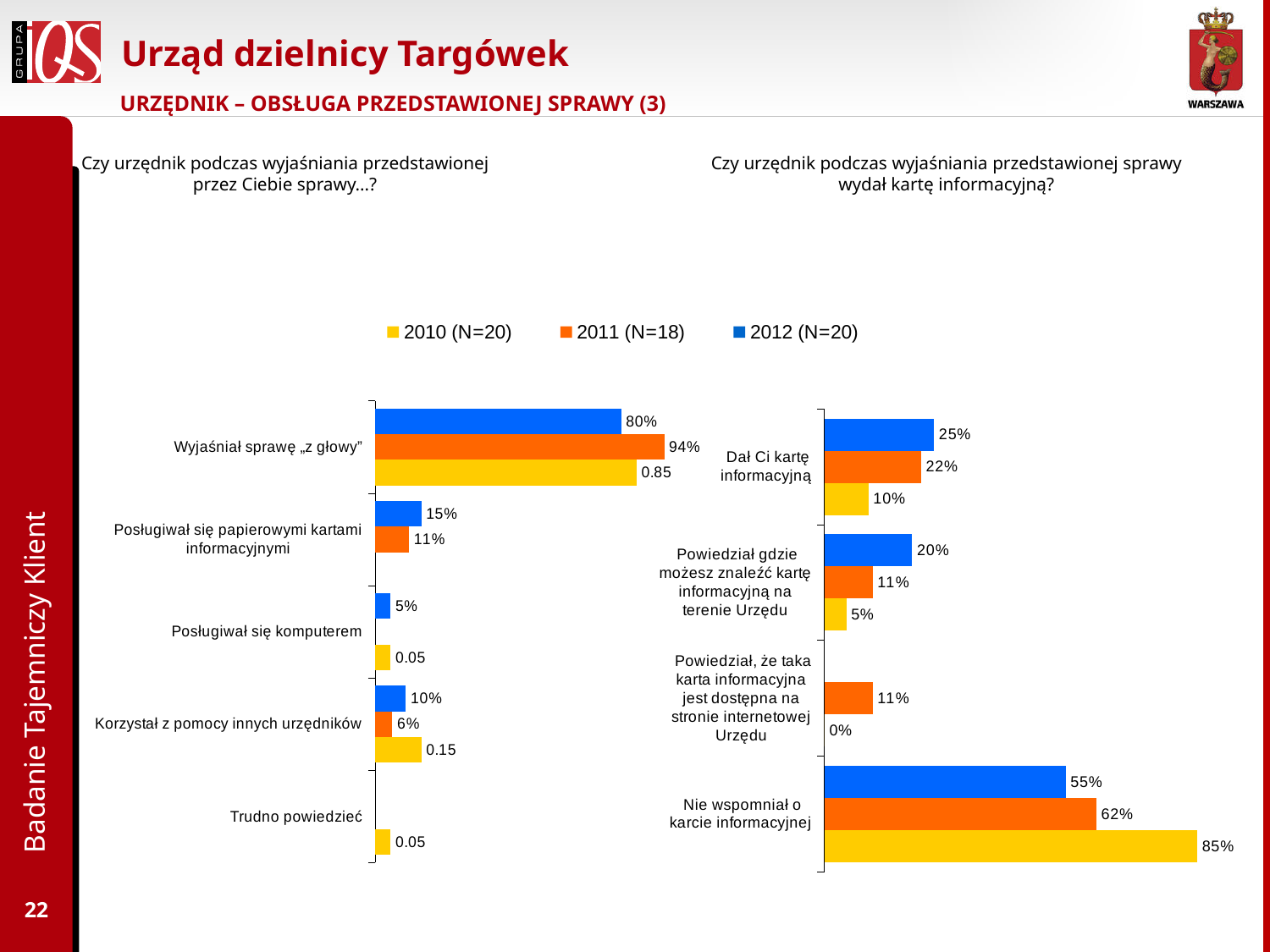
In the right chart, what is the 2010 (N=20) value for "Powiedział, że taka karta informacyjna jest dostępna na stronie internetowej Urzędu"? 0% In the right chart, what is the difference between the 2010 and 2012 values for "Nie wspomniał o karcie informacyjnej"? 30 percentage points In the right chart, which is larger for "Nie wspomniał o karcie informacyjnej": the 2011 value or the 2012 value? 2011 (62%) In the left chart, what is the difference between the 2012 and 2011 values for "Posługiwał się papierowymi kartami informacyjnymi"? 4 percentage points In the left chart, what is the 2011 (N=18) value for "Wyjaśniał sprawę „z głowy”"? 94% What type of chart is used on the slide? Bar chart In the left chart ("Czy urzędnik podczas wyjaśniania przedstawionej przez Ciebie sprawy...?"), what is the 2012 (N=20) value for "Wyjaśniał sprawę „z głowy”"? 80% In the right chart, what is the 2012 (N=20) value for "Dał Ci kartę informacyjną"? 25% How many series does the legend list? 3 In the right chart ("Czy urzędnik podczas wyjaśniania przedstawionej sprawy wydał kartę informacyjną?"), what is the 2010 (N=20) value for "Nie wspomniał o karcie informacyjnej"? 85% In the left chart, what is the 2010 (N=20) value for "Korzystał z pomocy innych urzędników"? 0.15 In the left chart, which category has the highest 2012 (N=20) value? Wyjaśniał sprawę „z głowy”